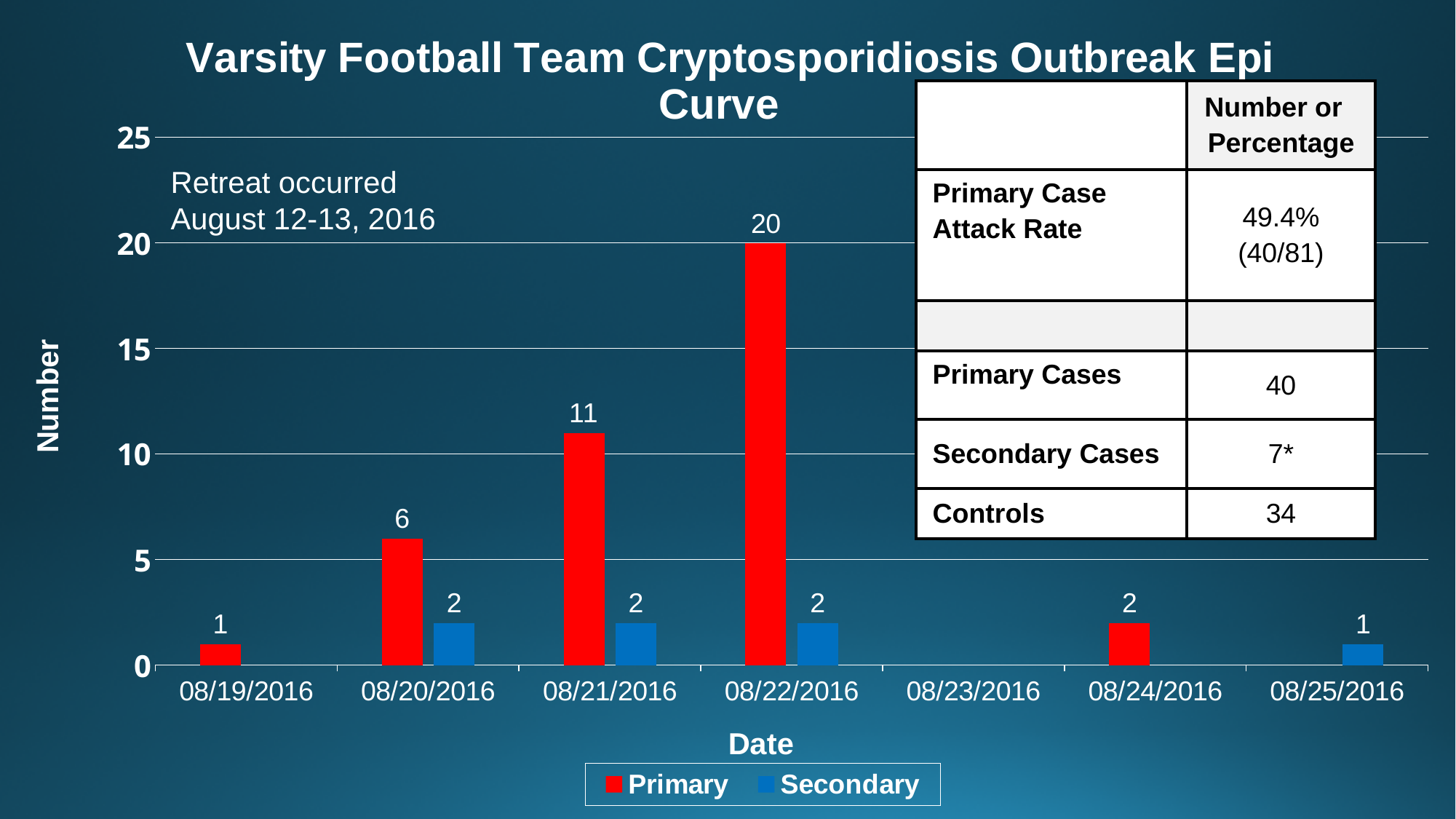
What kind of chart is shown? bar chart What is the Primary value on 08/24/2016? 2 How many dates are shown on the x axis? 7 How many series does the legend list? 2 On which date is the Primary series highest? 08/22/2016 Which is larger, the Primary value on 08/20/2016 or the Primary value on 08/21/2016? 08/21/2016 What is the difference between the Primary values on 08/22/2016 and 08/21/2016? 9 What is the Primary value on 08/22/2016? 20 What is the Secondary value on 08/21/2016? 2 Is the Primary value on 08/22/2016 greater or less than 15? greater What is the total of the Primary and Secondary values on 08/20/2016? 8 What is the label of the y axis? Number